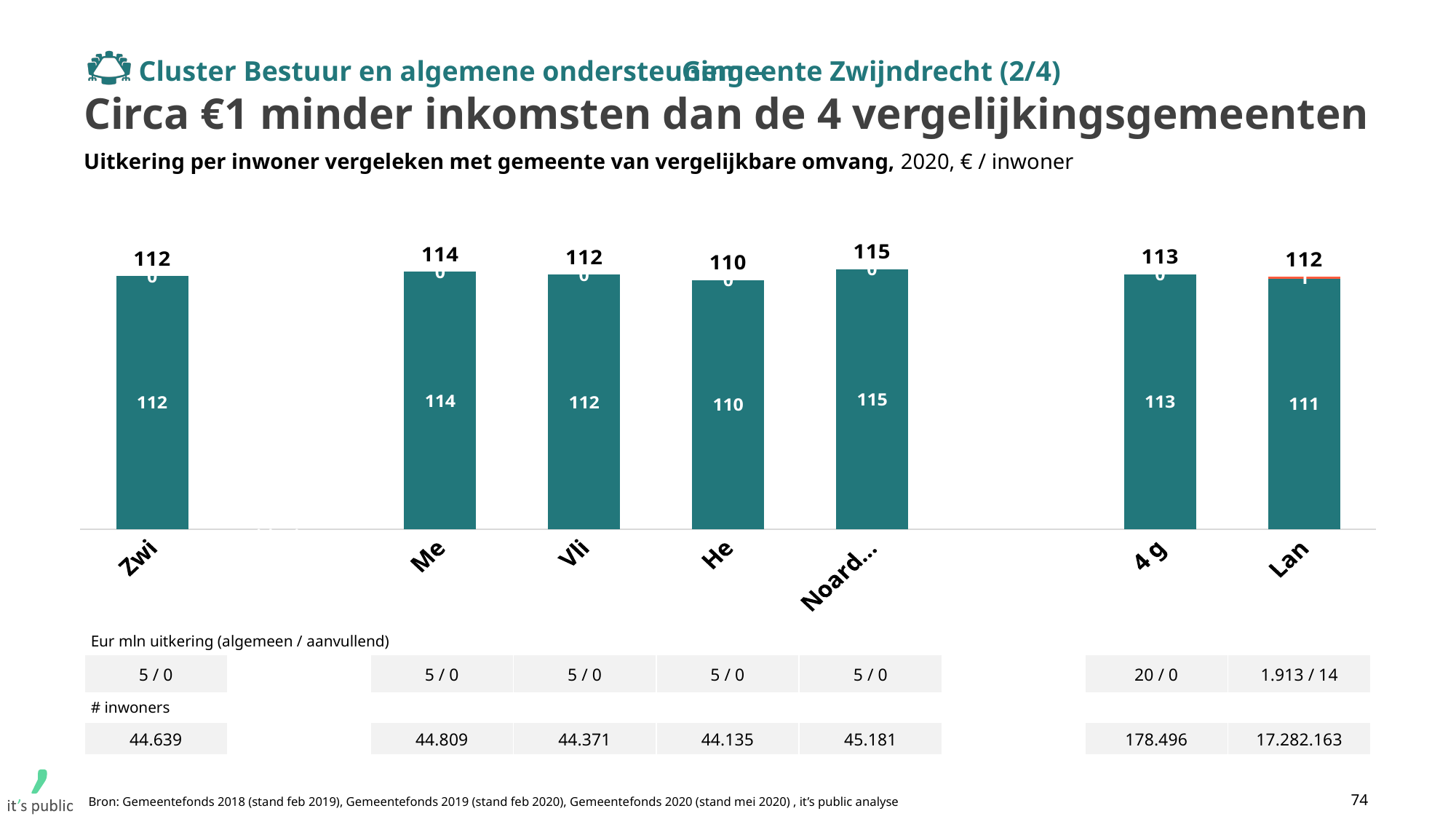
What is the value of the teal segment for Lan? 111 Which category has the highest total value? Noard... What is the total value shown above the bar for Me? 114 What is the total value shown above the bar for Zwi? 112 Which has a larger total, Me or Zwi? Me How many bars are shown in the chart? 7 What is the total value shown above the bar for 4 g? 113 What is the difference between the total for Noard... and the total for He? 5 What is the total of the stacked bar for Lan? 112 What kind of chart is shown on the slide? bar chart Which category has the lowest total value? He What is the value of the orange segment on top of the Lan bar? 1